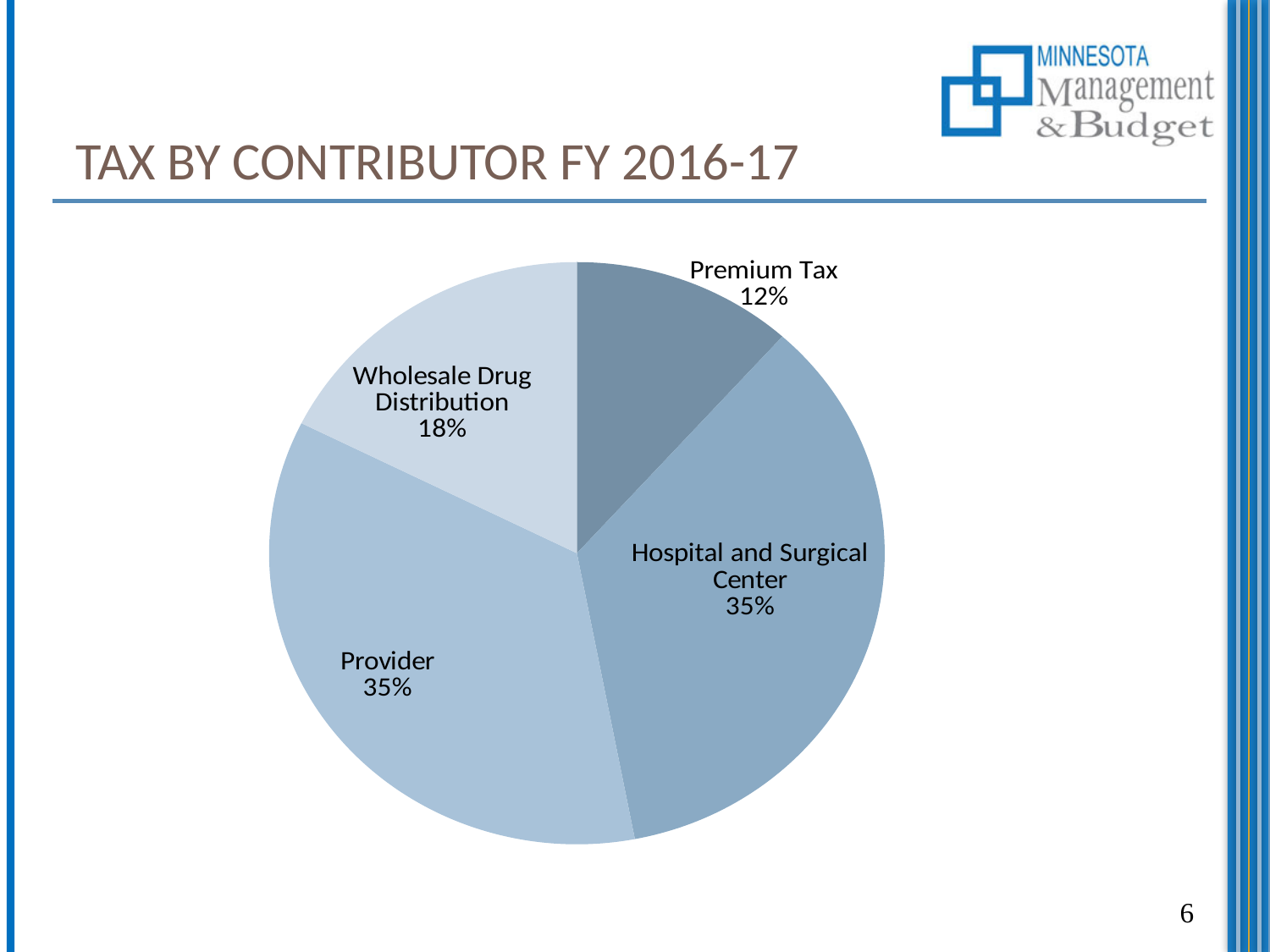
What share of the pie does Premium Tax represent? 12% Which is larger, the Wholesale Drug Distribution slice or the Premium Tax slice? Wholesale Drug Distribution What is the value shown for Provider? 35% What share of the pie does Wholesale Drug Distribution represent? 18% What is the title of the slide containing the pie chart? TAX BY CONTRIBUTOR FY 2016-17 What is the difference between the Provider share and the Wholesale Drug Distribution share? 17% How many slices does the pie chart have? 4 What is the combined share of Provider and Hospital and Surgical Center? 70% Which contributor has the smallest slice of the pie? Premium Tax What kind of chart is shown on the slide? pie chart What is the difference between the Wholesale Drug Distribution share and the Premium Tax share? 6% What is the value shown for Hospital and Surgical Center? 35%